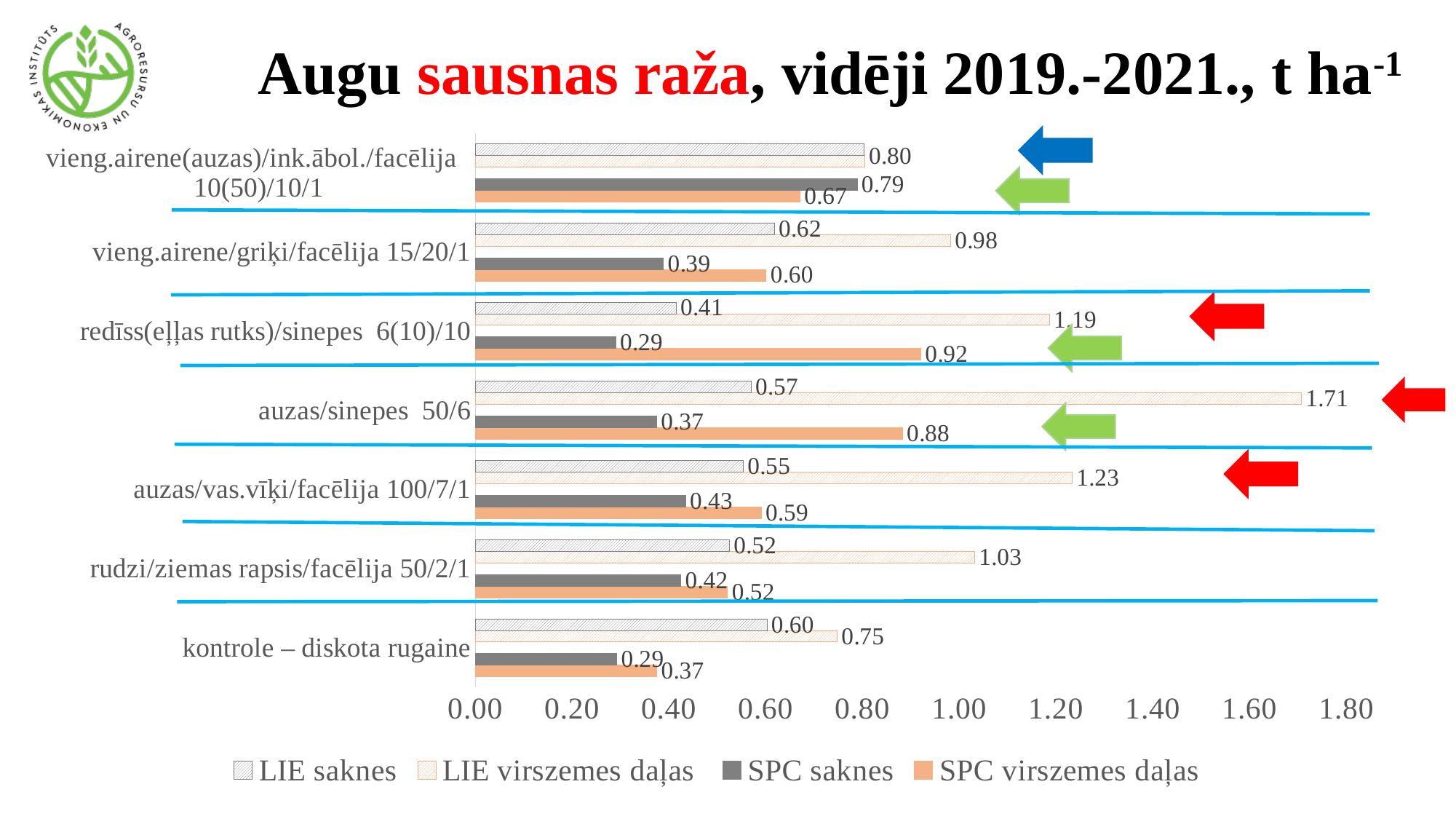
What is the value of LIE virszemes daļas for auzas/sinepes 50/6? 1.71 How many series does the legend list? 4 What kind of chart is shown on the slide? bar chart Which category has the lowest SPC virszemes daļas value? kontrole – diskota rugaine How many categories are shown on the chart? 7 Which has the larger SPC virszemes daļas value: auzas/sinepes 50/6 or auzas/vas.vīķi/facēlija 100/7/1? auzas/sinepes 50/6 What is the value of SPC saknes for kontrole – diskota rugaine? 0.29 What is the difference between LIE virszemes daļas and SPC virszemes daļas for redīss(eļļas rutks)/sinepes 6(10)/10? 0.27 Which category has the highest LIE virszemes daļas value? auzas/sinepes 50/6 Is the LIE virszemes daļas value for rudzi/ziemas rapsis/facēlija 50/2/1 greater or less than 1.00? greater What is the value of SPC saknes for auzas/vas.vīķi/facēlija 100/7/1? 0.43 What is the title of the chart? Augu sausnas raža, vidēji 2019.-2021., t ha-1